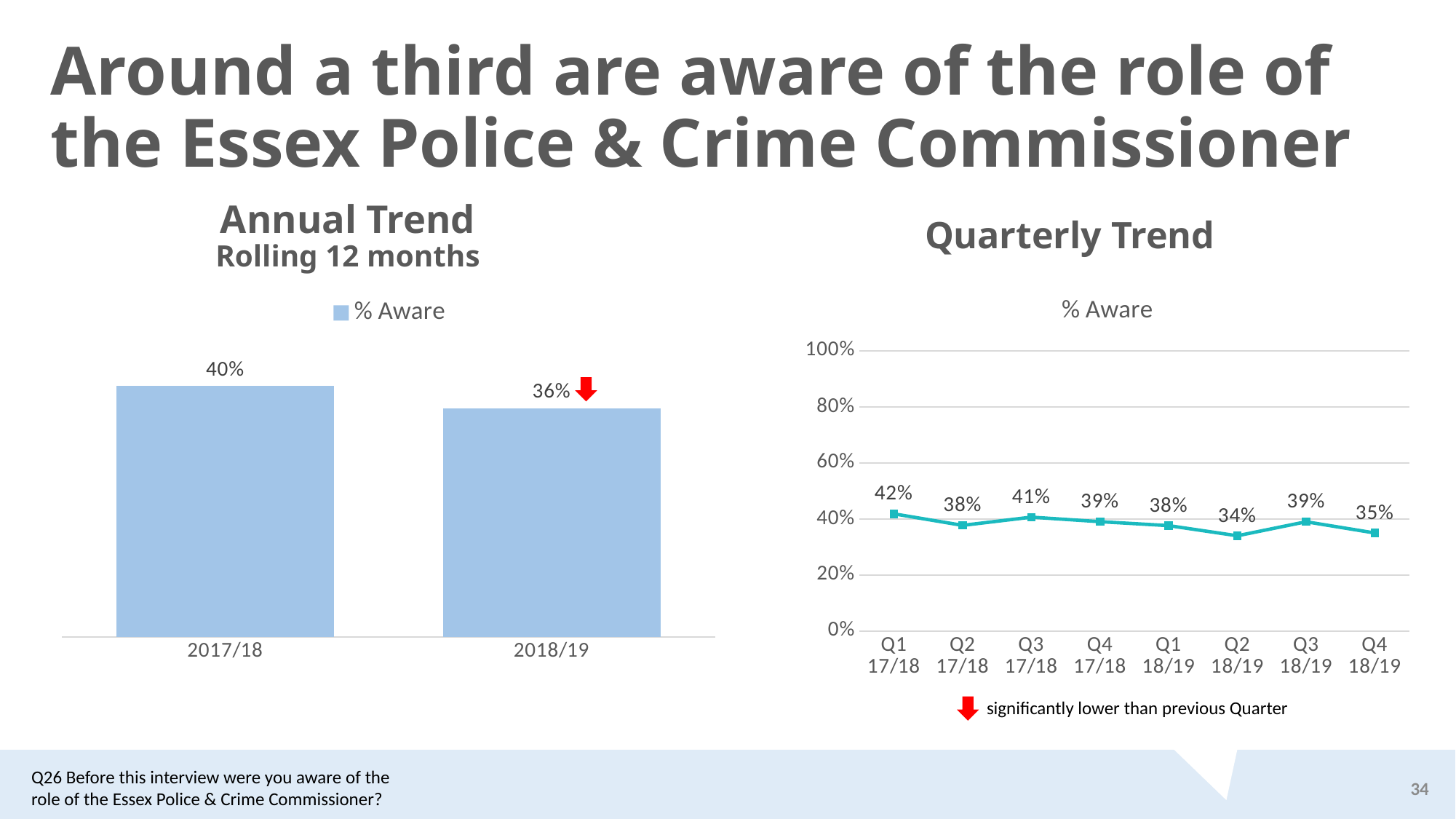
In the Quarterly Trend chart, which quarter has the highest % Aware value? Q1 17/18 In the Quarterly Trend chart, what is the % Aware value for Q1 17/18? 42% In the Quarterly Trend chart, what is the % Aware value for Q2 18/19? 34% In the Quarterly Trend chart, which quarter has the lowest % Aware value? Q2 18/19 In the Annual Trend chart, what is the % Aware value for 2018/19? 36% In the Quarterly Trend chart, how many quarters are plotted? 8 In the Annual Trend chart, what is the difference between the 2017/18 and 2018/19 values? 4 percentage points How many categories are shown in the Annual Trend chart? 2 What kind of chart is the Quarterly Trend chart? Line chart In the Quarterly Trend chart, is the value for Q3 17/18 greater or less than Q4 18/19? Q3 17/18 is greater In the Annual Trend chart, what is the % Aware value for 2017/18? 40% What kind of chart is the Annual Trend chart? Bar chart